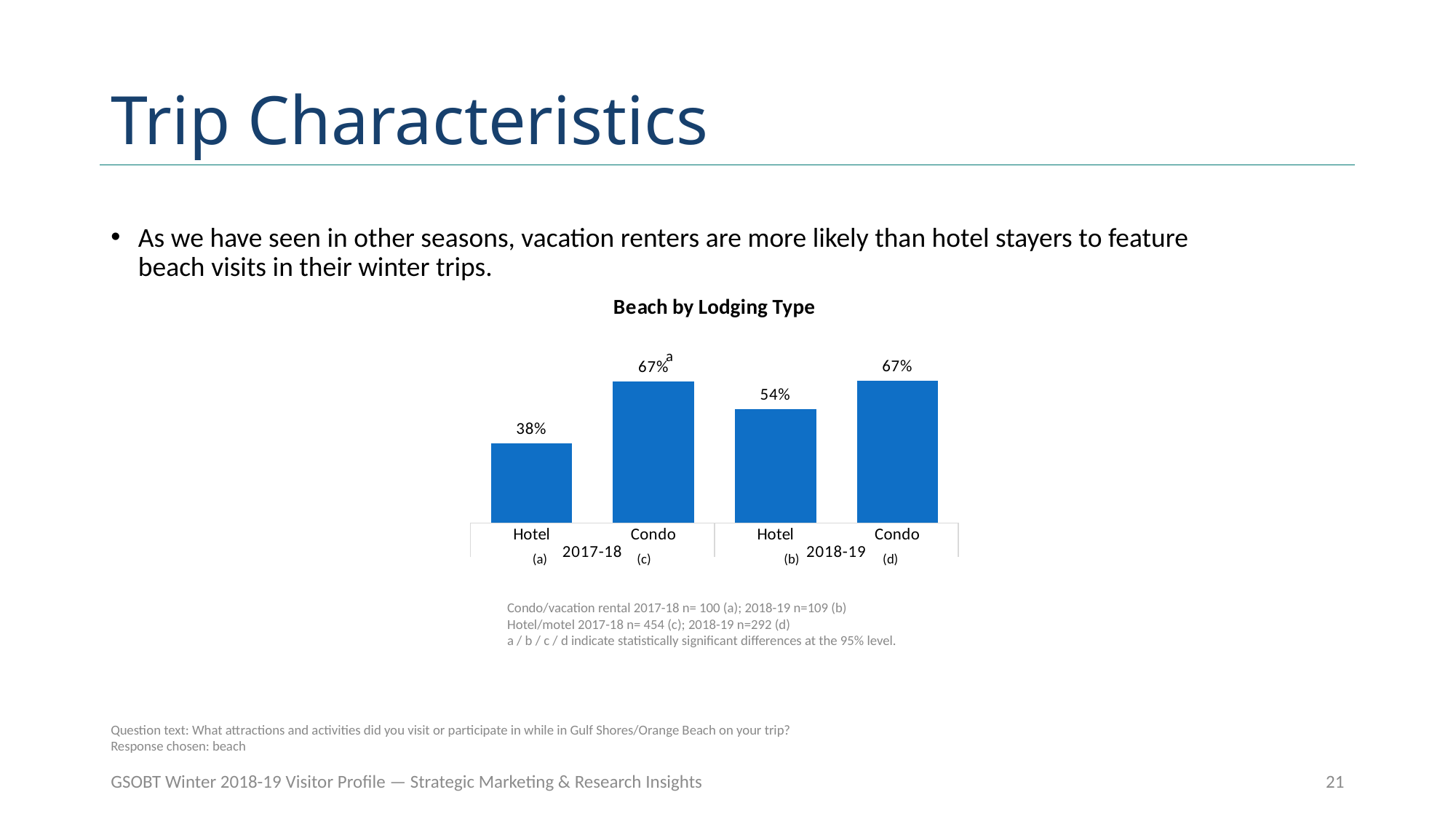
What is the title of the chart on the slide? Beach by Lodging Type What is the difference between the Condo and Hotel values for 2017-18? 29% What is the value for Condo in 2017-18 in the Beach by Lodging Type chart? 67% Did the Hotel value rise or fall from 2017-18 to 2018-19? Rise What is the difference between the Condo and Hotel values for 2018-19? 13% What is the value for Hotel in 2018-19 in the Beach by Lodging Type chart? 54% What kind of chart is shown on the slide? Bar chart Which is larger, the Hotel value for 2017-18 or the Hotel value for 2018-19? Hotel 2018-19 How many bars are plotted in the Beach by Lodging Type chart? 4 Which bar has the lowest value in the Beach by Lodging Type chart? Hotel 2017-18 What is the value for Hotel in 2017-18 in the Beach by Lodging Type chart? 38% What is the value for Condo in 2018-19 in the Beach by Lodging Type chart? 67%